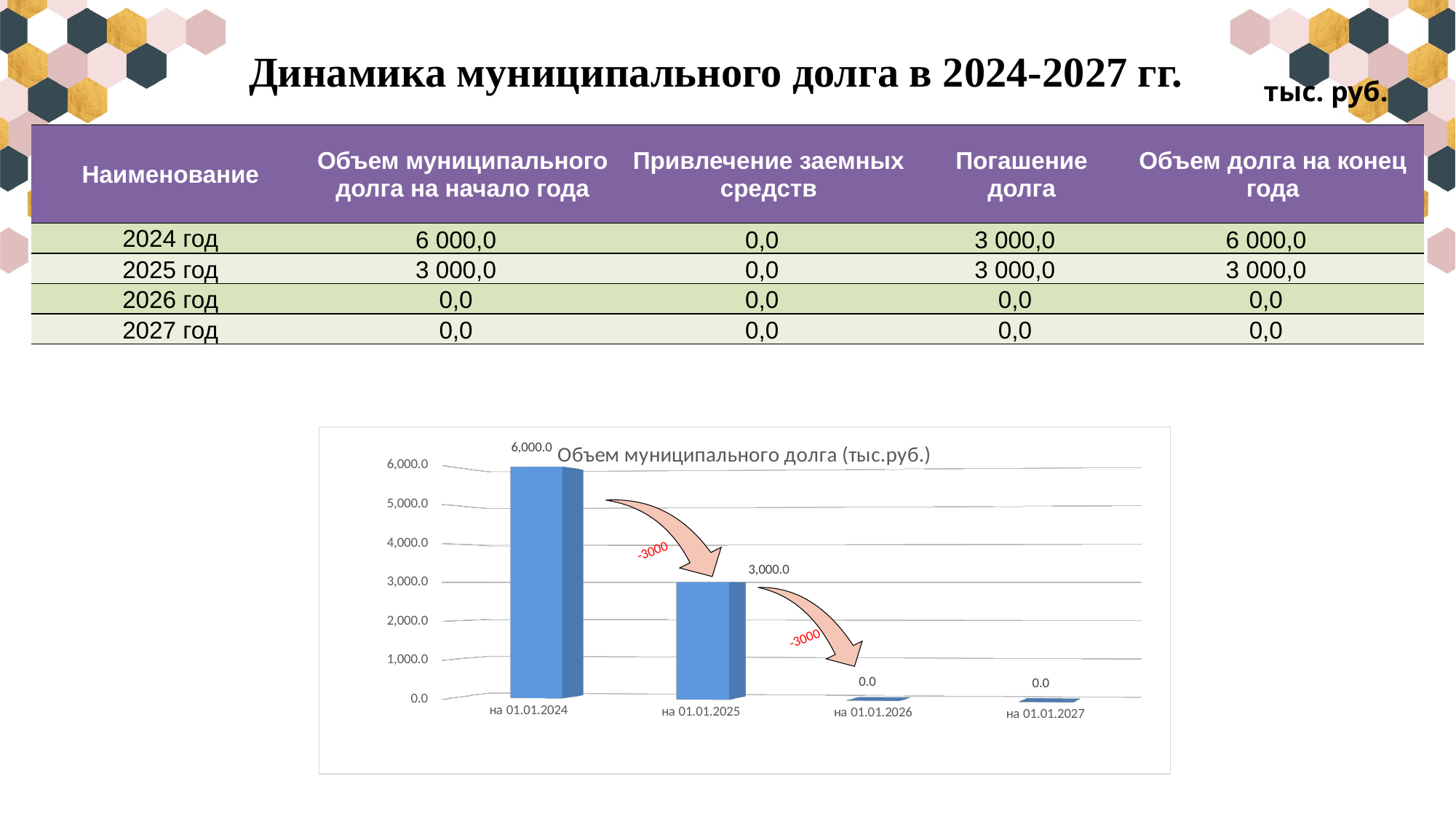
Is the value for на 01.01.2025 greater or less than 4,000.0? less What is the difference between the values for на 01.01.2024 and на 01.01.2025? 3,000.0 Which category has the highest value in the chart? на 01.01.2024 Do the values rise or fall along the x axis of the chart? fall What is the title of the chart? Объем муниципального долга (тыс.руб.) What kind of chart is shown on the slide? bar chart How many categories are shown on the x axis of the chart? 4 What is the value for на 01.01.2024 in the chart? 6,000.0 What change is written in red next to the arrow between на 01.01.2024 and на 01.01.2025? -3000 Which is larger, the value for на 01.01.2024 or на 01.01.2025? на 01.01.2024 What is the value for на 01.01.2026 in the chart? 0.0 What is the value for на 01.01.2025 in the chart? 3,000.0